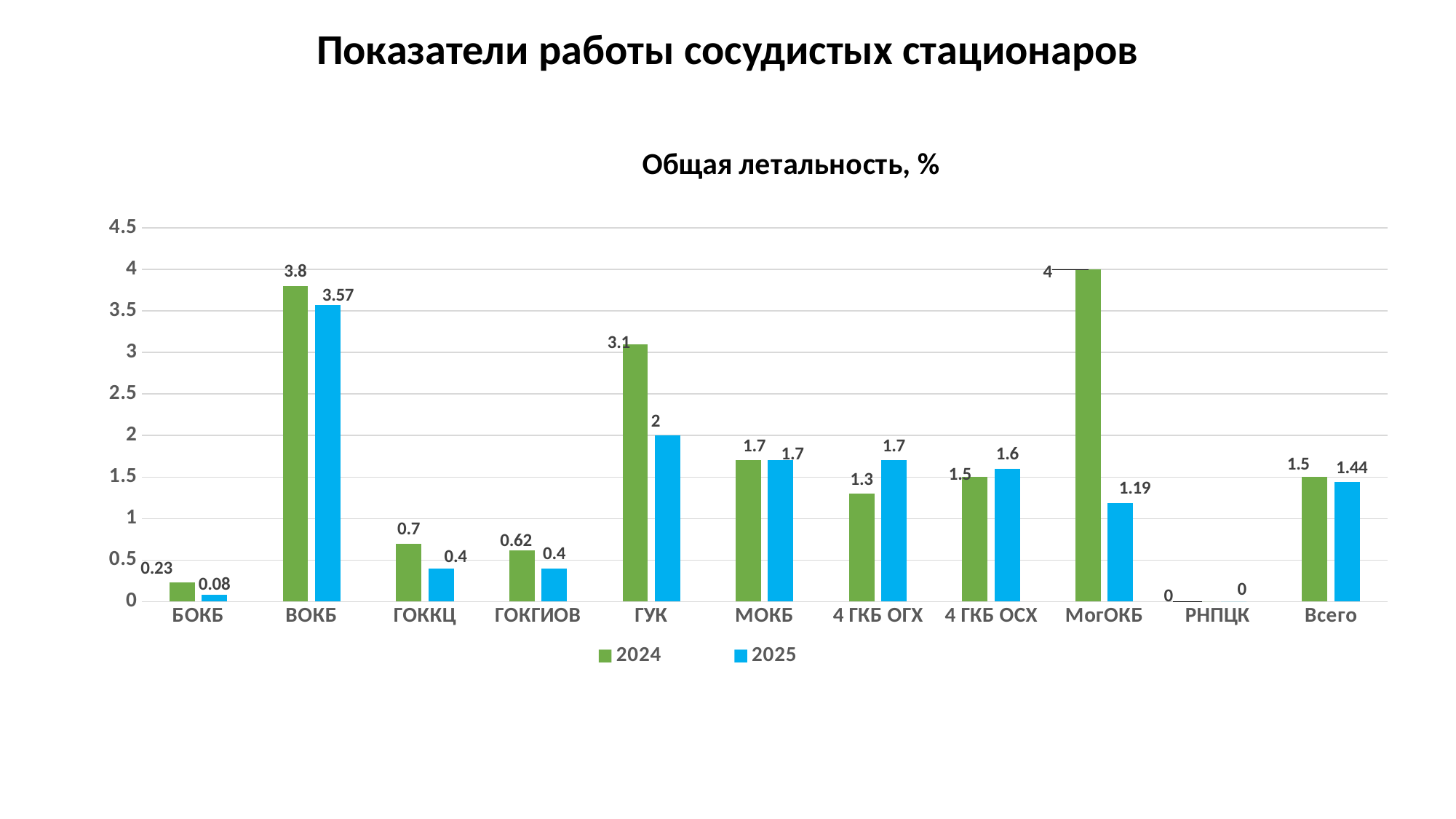
How many series does the legend list? 2 Which category has the highest 2024 value? МогОКБ What is the difference between the 2024 and 2025 values for ГУК? 1.1 What is the 2025 value for Всего? 1.44 What type of chart is shown on the slide? Bar chart How many categories are shown on the x axis? 11 What is the 2025 value for МогОКБ? 1.19 What is the 2024 value for ВОКБ? 3.8 Which category has the highest 2025 value? ВОКБ Is the 2024 value for ГУК greater or less than 3? greater Which is larger for 4 ГКБ ОГХ: the 2024 value or the 2025 value? 2025 Which category has the lowest 2025 value? РНПЦК